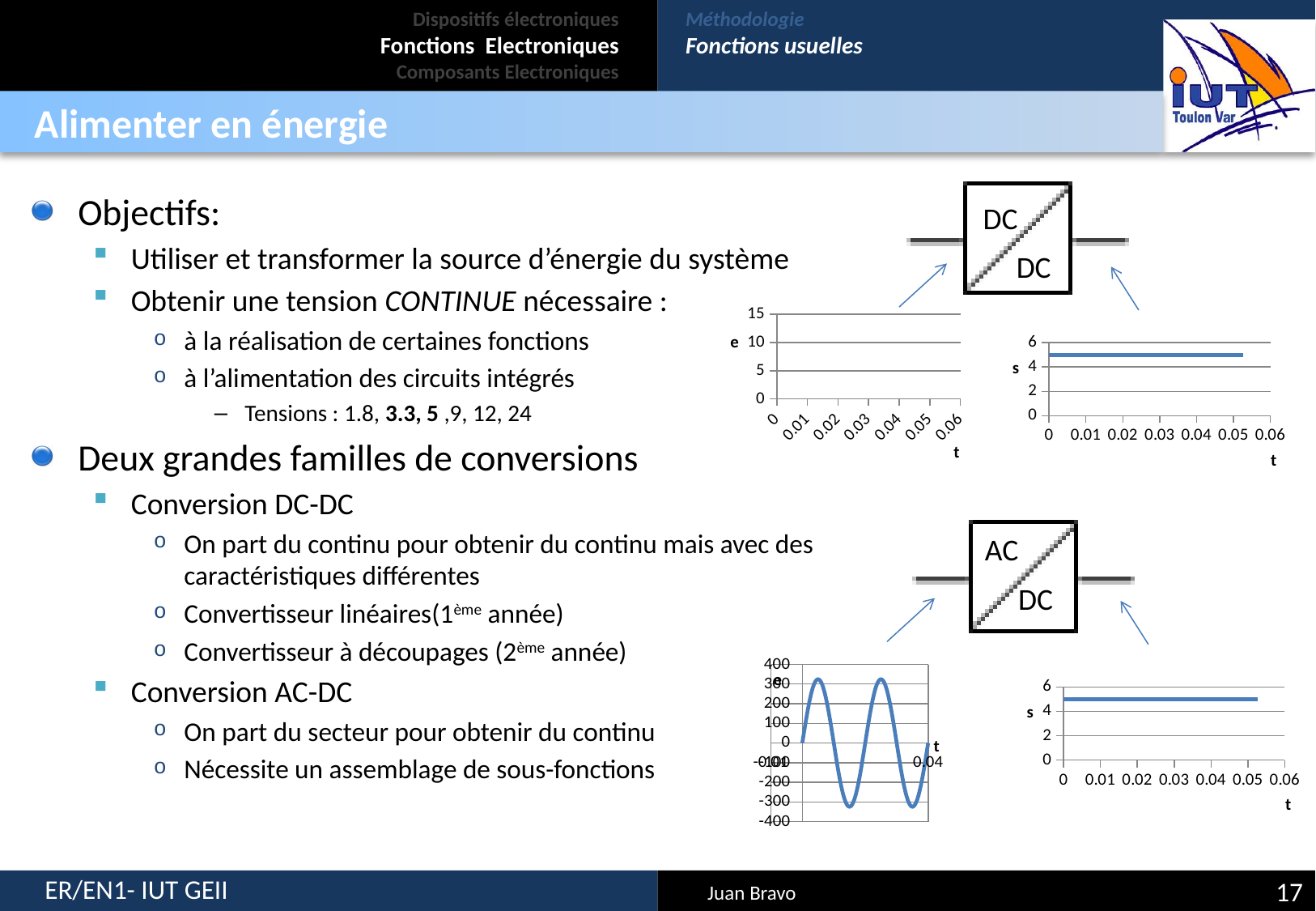
How many tick labels are shown on the horizontal axis of the chart at the top right of the slide (labelled s)? 7 What is the highest value shown on the vertical axis of the chart at the top left of the slide (labelled e)? 15 In the chart at the bottom left of the slide (labelled e), is the lowest value of the wave greater or less than -200? less In the chart at the top right of the slide (labelled s), does the plotted value rise, fall or stay constant along the t axis? stays constant In the chart at the top right of the slide (labelled s), is the plotted value greater or less than 6? less What is the highest value shown on the vertical axis of the chart at the bottom left of the slide (labelled e)? 400 In the chart at the top right of the slide (labelled s), is the plotted value greater or less than 4? greater In the chart at the bottom right of the slide (labelled s), does the plotted value rise, fall or stay constant along the t axis? stays constant What kind of chart is the chart at the top right of the slide (labelled s)? line chart